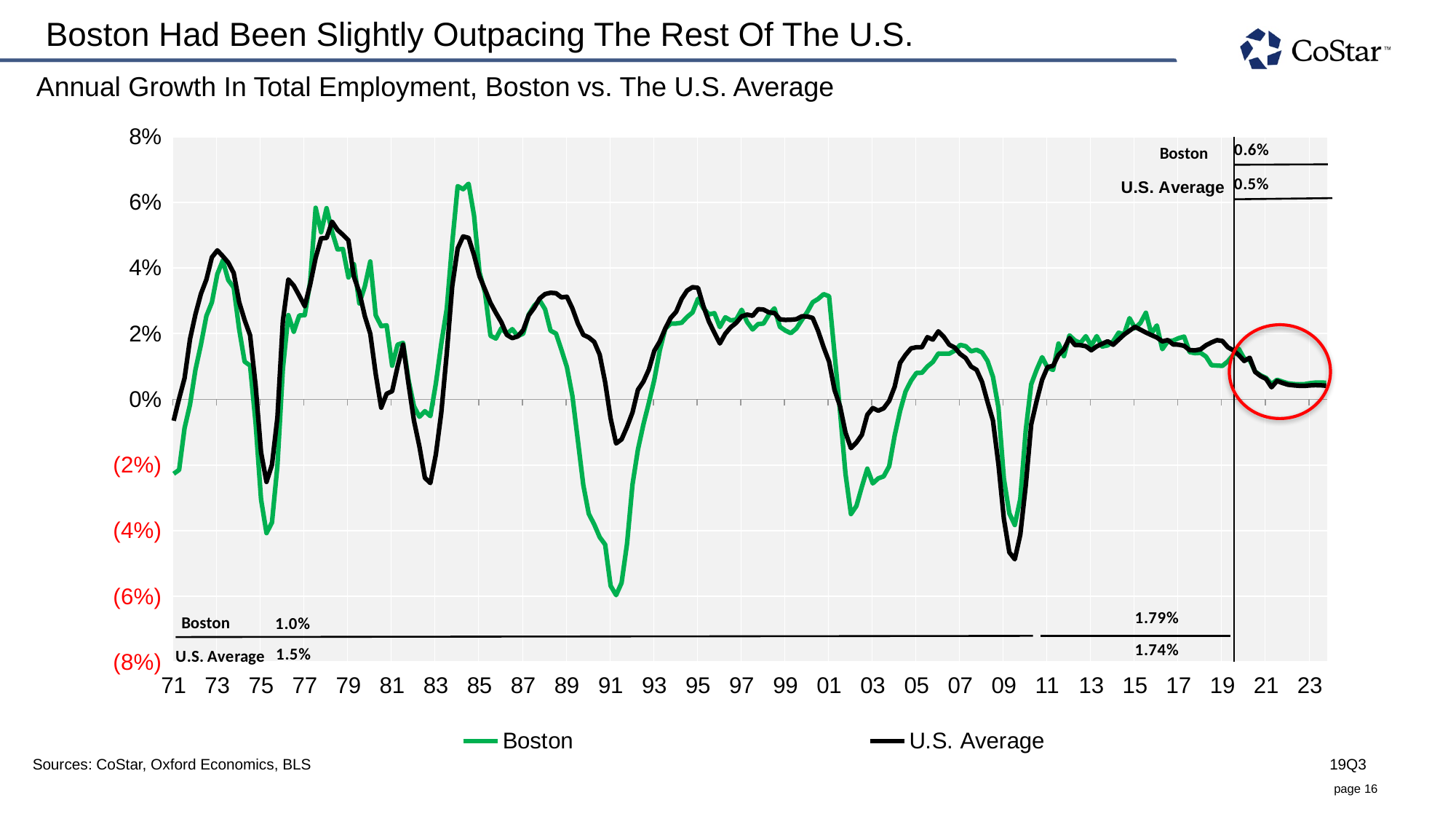
What is the annotated U.S. Average growth for the 1971-2010 period? 1.5% For the 1971-2010 period, which annotated value is larger: Boston (1.0%) or U.S. Average (1.5%)? U.S. Average What is the annotated Boston value for the forecast period after 2019? 0.6% What is the annotated U.S. Average value for the forecast period after 2019? 0.5% Is the U.S. Average value at its low point around 2009 greater or less than (4%)? less What is the annotated Boston average growth for the 2011-2019 period? 1.79% Is the Boston value at its low point around 1991 greater or less than (4%)? less What kind of chart is shown on the slide? line chart Around 1991, which series reaches the lower value, Boston or U.S. Average? Boston What is the difference between the annotated Boston (1.79%) and U.S. Average (1.74%) values for the 2011-2019 period? 0.05% What are the two series named in the legend? Boston and U.S. Average How many series does the legend list? 2